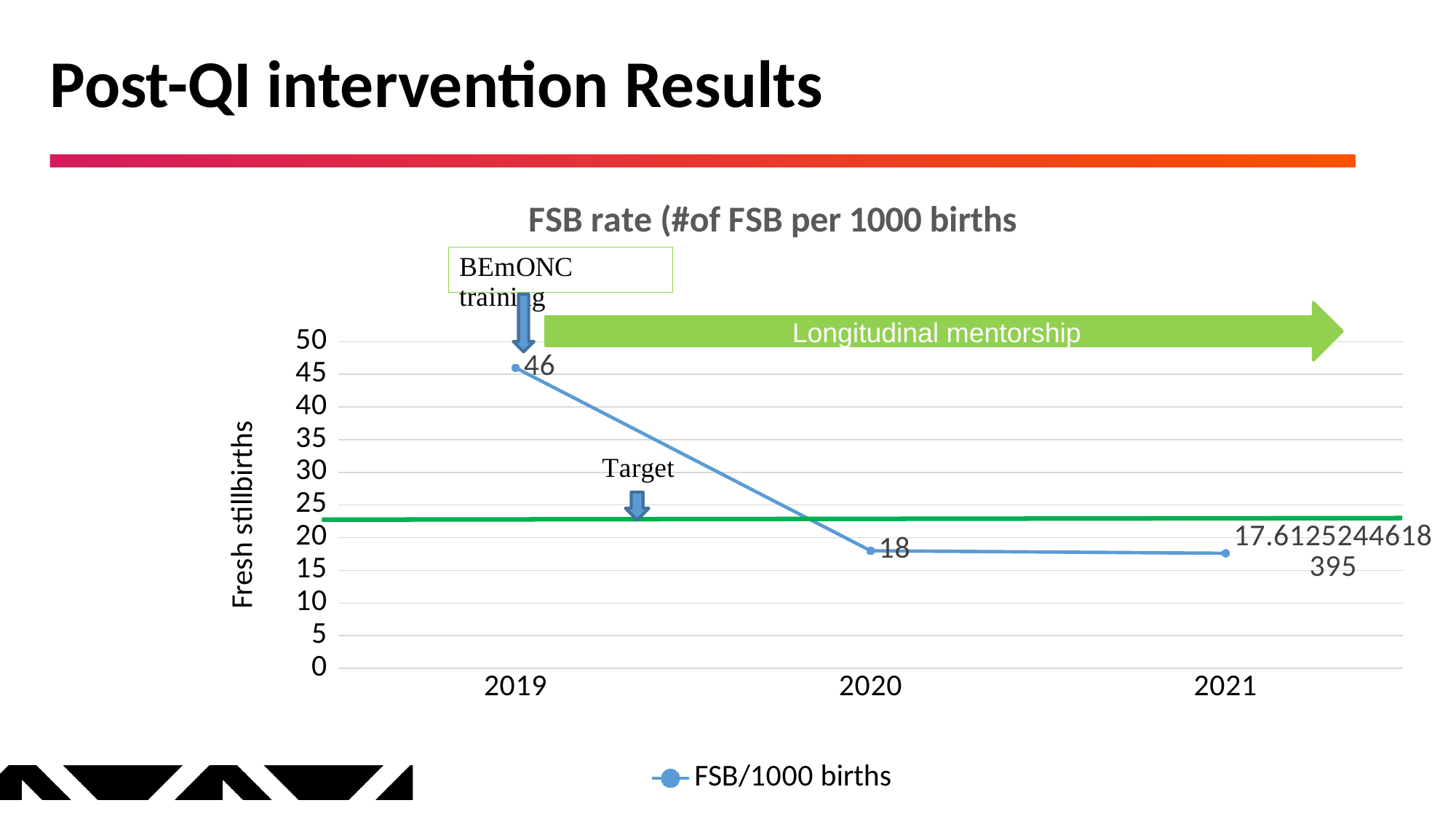
What is the FSB/1000 births value for 2021 as printed on the chart? 17.6125244618395 How many years are plotted on the x axis of the chart? 3 Which year has the highest FSB/1000 births value? 2019 How many series does the chart legend list? 1 Is the FSB/1000 births value for 2021 greater or less than 20? less What is the FSB/1000 births value for 2020? 18 What is the FSB/1000 births value for 2019? 46 Do the FSB/1000 births values rise or fall from 2019 to 2021? fall What is the difference between the FSB/1000 births values for 2019 and 2020? 28 What is the label of the y axis of the chart? Fresh stillbirths Which is larger, the FSB/1000 births value for 2019 or for 2020? 2019 What kind of chart is shown on the slide? line chart